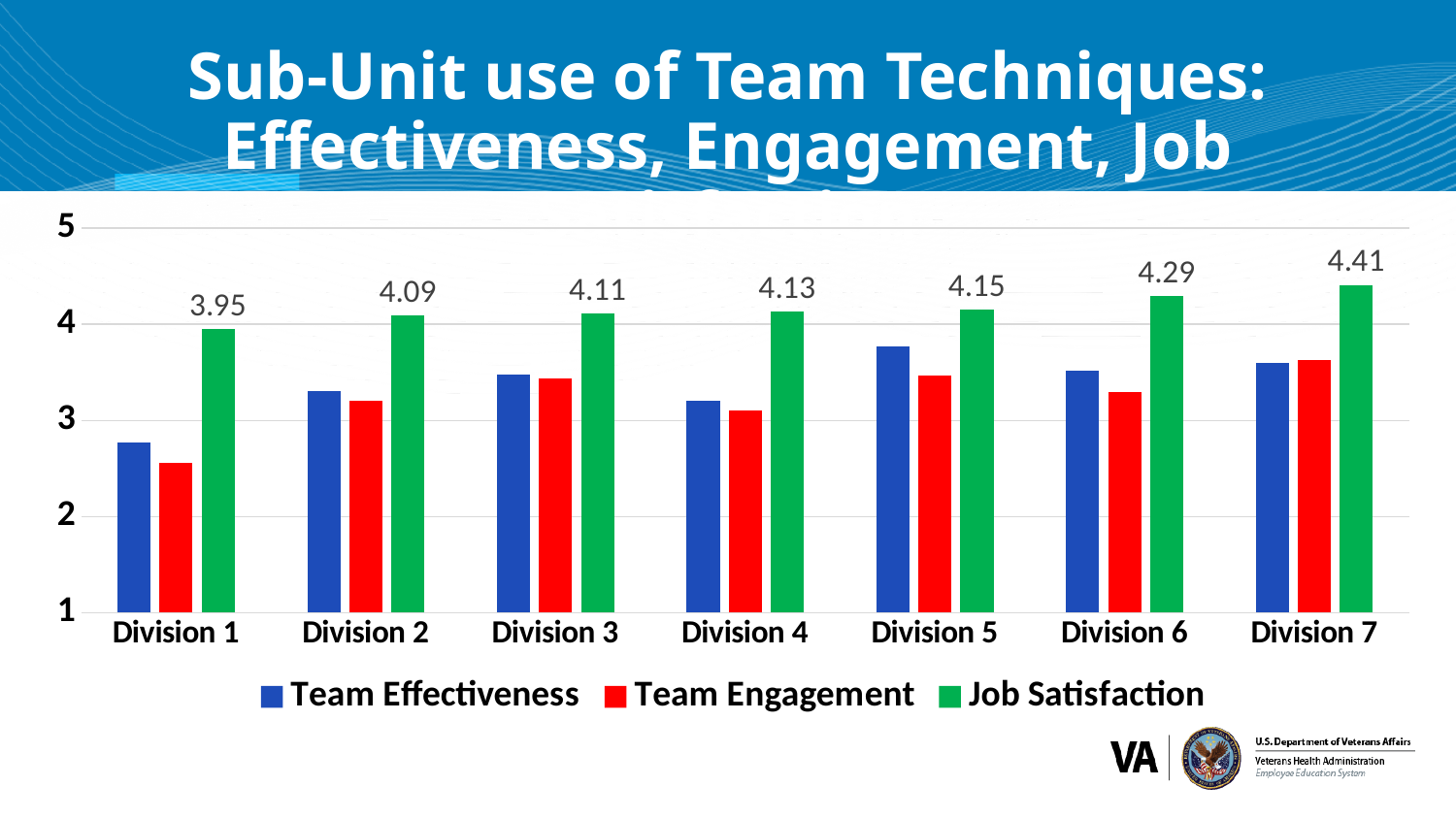
Which division has the lowest Job Satisfaction value? Division 1 For Division 5, which is larger: Team Effectiveness or Team Engagement? Team Effectiveness How many series does the legend list? 3 What is the Job Satisfaction value for Division 1? 3.95 How many divisions are shown on the x axis? 7 What is the Job Satisfaction value for Division 6? 4.29 Is the Team Effectiveness value for Division 5 greater or less than 4? less Which division has the highest Job Satisfaction value? Division 7 Do the Job Satisfaction values rise or fall from Division 1 to Division 7? Rise Is the Team Effectiveness value for Division 1 greater or less than 3? less What is the difference between the Job Satisfaction values for Division 7 and Division 1? 0.46 What kind of chart is shown on the slide? Bar chart